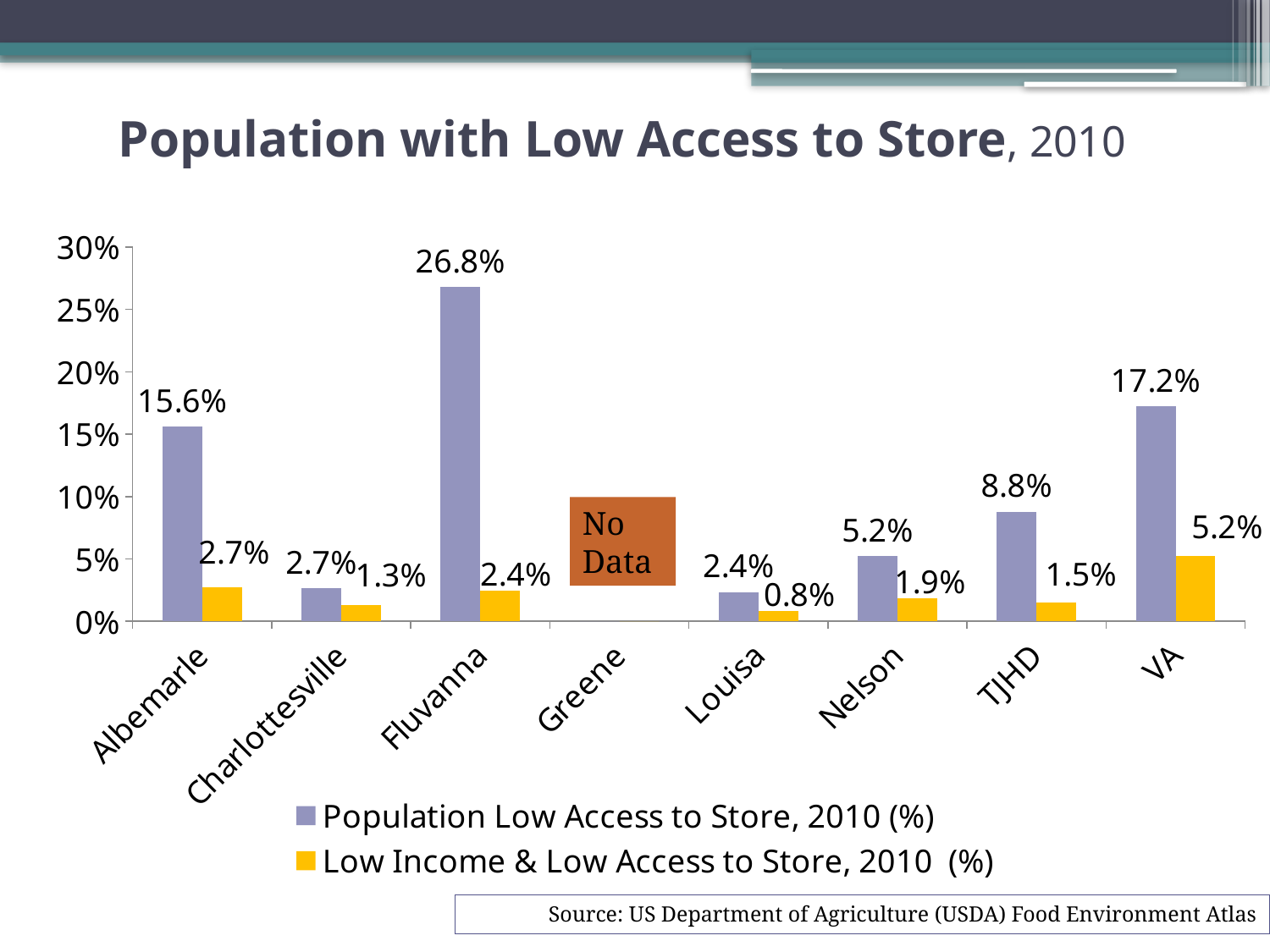
How many categories are shown on the x axis of the chart? 8 What is the Population Low Access to Store, 2010 (%) value for Fluvanna? 26.8% What is the difference between the Population Low Access to Store value and the Low Income & Low Access to Store value for Albemarle? 12.9 percentage points What kind of chart is shown on the slide? Bar chart Which category has the lowest Low Income & Low Access to Store, 2010 (%) value? Louisa How much higher is the Population Low Access to Store, 2010 (%) value for VA than for Albemarle? 1.6 percentage points Which has a larger Population Low Access to Store, 2010 (%) value, Albemarle or VA? VA What is the Low Income & Low Access to Store, 2010 (%) value for VA? 5.2% Which category on the chart is marked as having no data? Greene How many series does the legend list? 2 Which category has the highest Population Low Access to Store, 2010 (%) value? Fluvanna What is the Population Low Access to Store, 2010 (%) value for TJHD? 8.8%